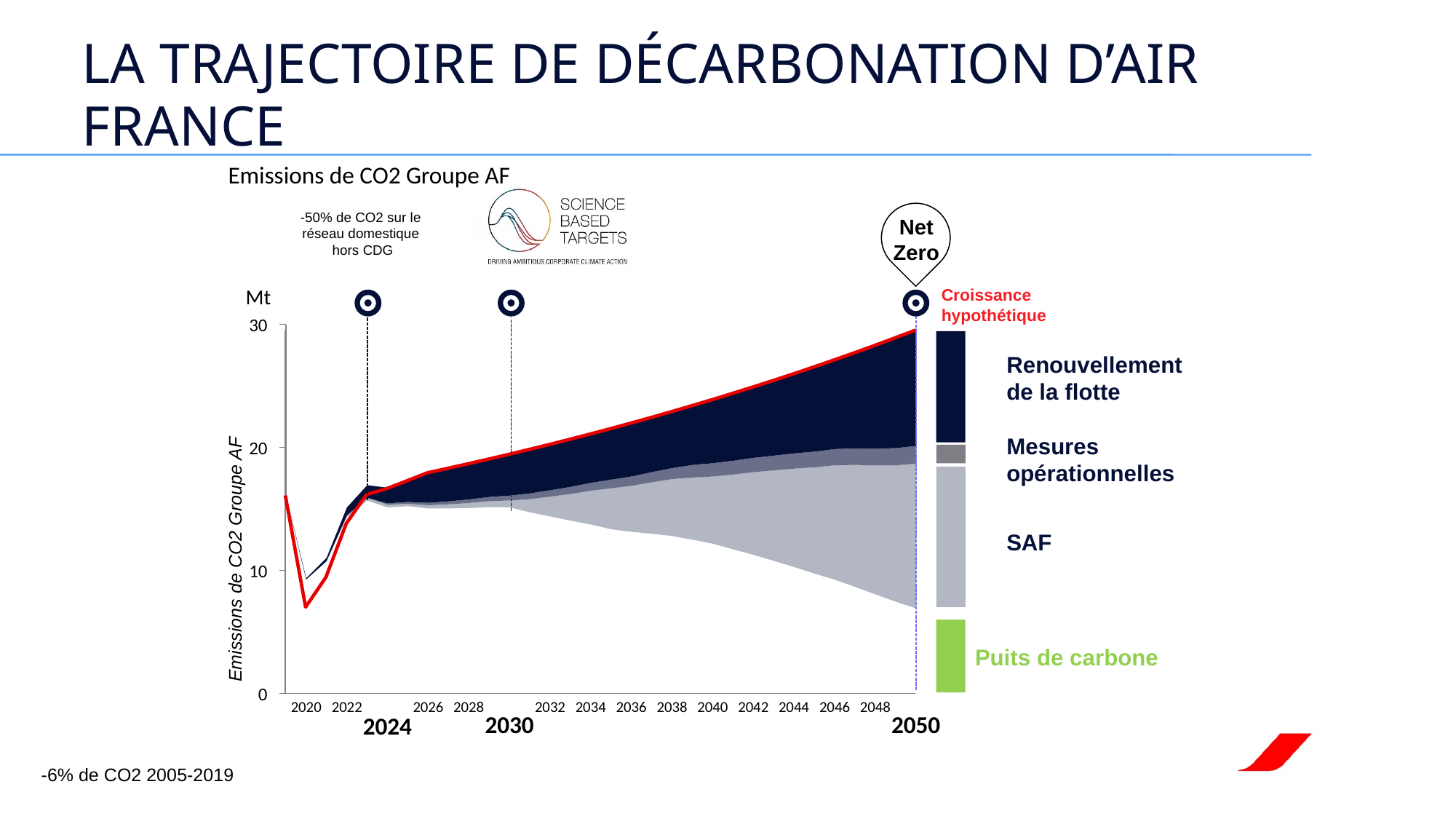
Is the lower edge of the SAF area in 2050 greater or less than 10? less Does the red 'Croissance hypothétique' line rise or fall between 2024 and 2050? rise Is the value of the red 'Croissance hypothétique' line in 2030 greater or less than 10? greater Is the value of the red 'Croissance hypothétique' line in 2050 greater or less than 20? greater What unit is shown on the y axis of the chart? Mt Which year is marked with the 'Net Zero' label on the chart? 2050 What is the title of the chart? Emissions de CO2 Groupe AF Which is larger: the value of the red line in 2050 or in 2020? 2050 What kind of chart is shown on the slide? Area chart How many decarbonisation levers are listed in the legend to the right of the chart? 4